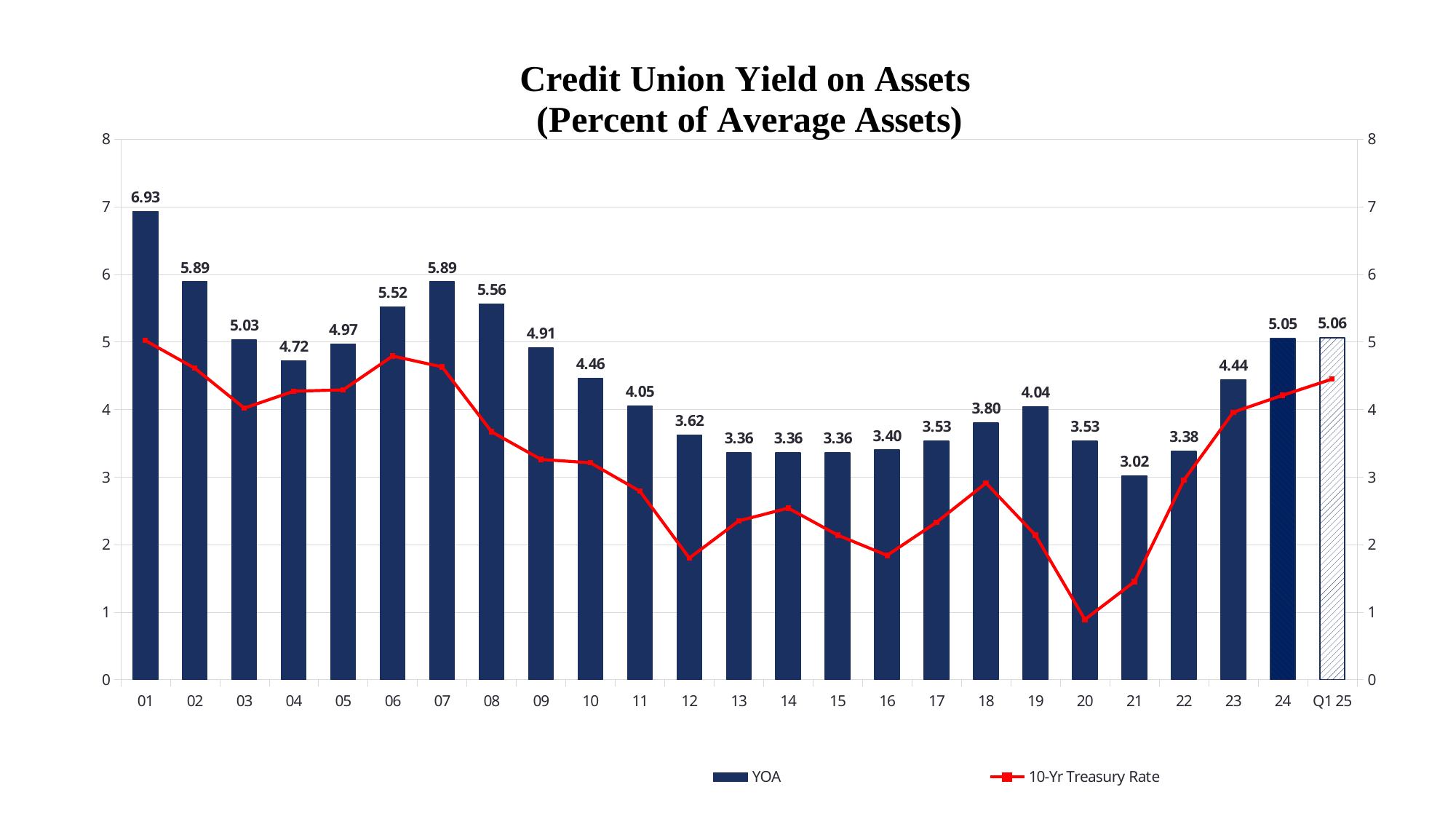
Is the 10-Yr Treasury Rate for 20 greater or less than 1? less What is the YOA value for Q1 25? 5.06 Which year has the lowest YOA? 21 What is the YOA value for 01? 6.93 How many series does the legend list? 2 Which has a higher YOA, 07 or 08? 07 Which year has the highest YOA? 01 How many categories are shown on the x axis? 25 What is the difference between the YOA for 01 and the YOA for 24? 1.88 What is the difference between the YOA for 24 and the YOA for 23? 0.61 Does the YOA rise or fall from 21 to 24? rises Is the 10-Yr Treasury Rate for 01 greater or less than 4? greater